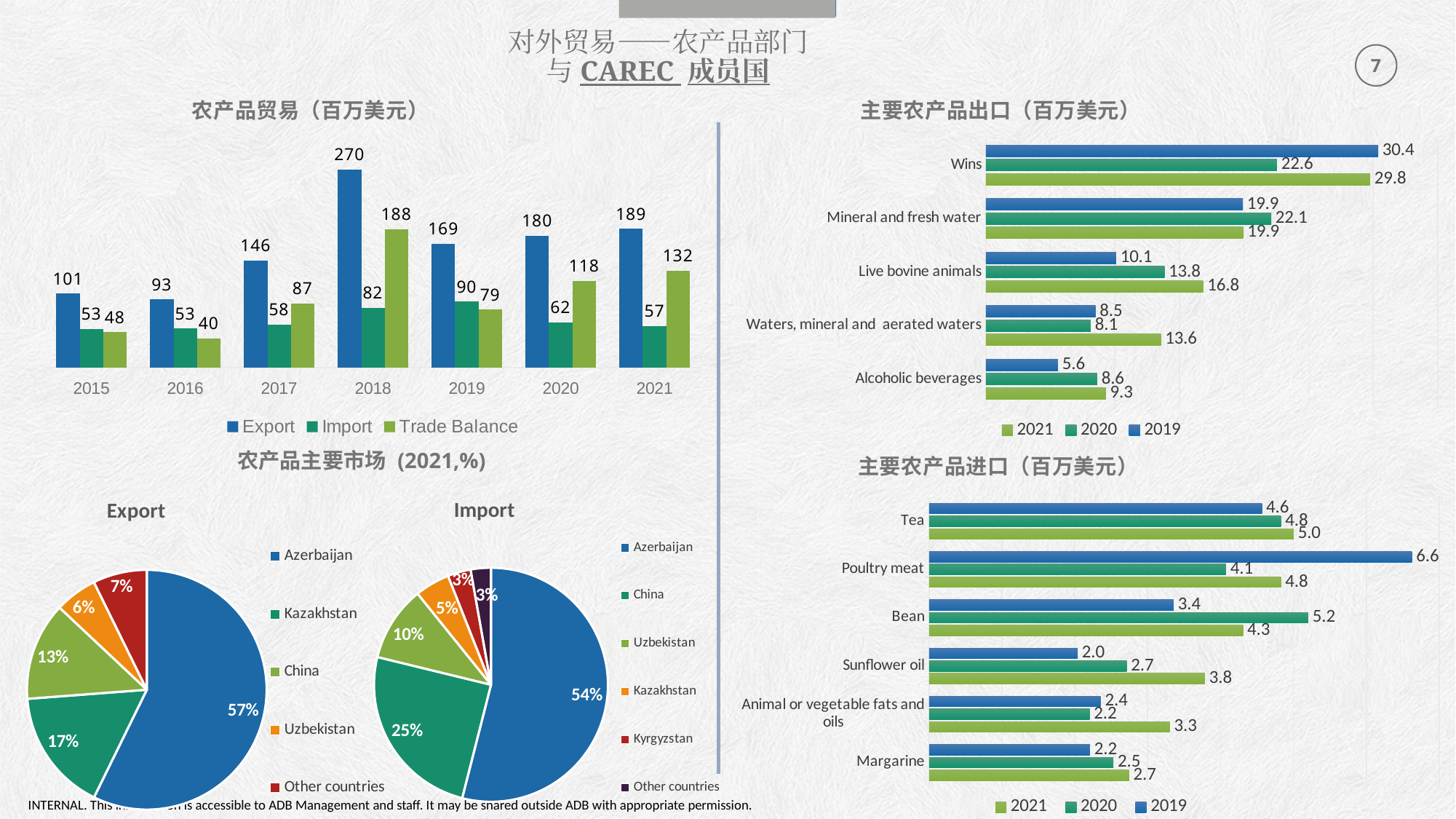
In the 农产品贸易（百万美元） bar chart, which year has the highest Export value? 2018 In the 农产品贸易（百万美元） bar chart, what is the difference between Export and Import in 2021? 132 In the Import pie chart under 农产品主要市场 (2021,%), how many slices are there? 6 In the 农产品贸易（百万美元） bar chart, what is the Export value for 2018? 270 In the Import pie chart under 农产品主要市场 (2021,%), what share does China have? 25% In the 主要农产品进口（百万美元） chart, what is the 2019 value for Poultry meat? 6.6 What type of chart is the 主要农产品进口（百万美元） chart? bar chart In the 农产品贸易（百万美元） bar chart, what is the Import value for 2021? 57 In the 农产品贸易（百万美元） bar chart, how many series does the legend list? 3 In the 主要农产品出口（百万美元） chart, what is the 2019 value for Wins? 30.4 In the 主要农产品出口（百万美元） chart, which is larger for Live bovine animals: the 2021 value or the 2019 value? 2021 In the Export pie chart under 农产品主要市场 (2021,%), what share does Azerbaijan have? 57%